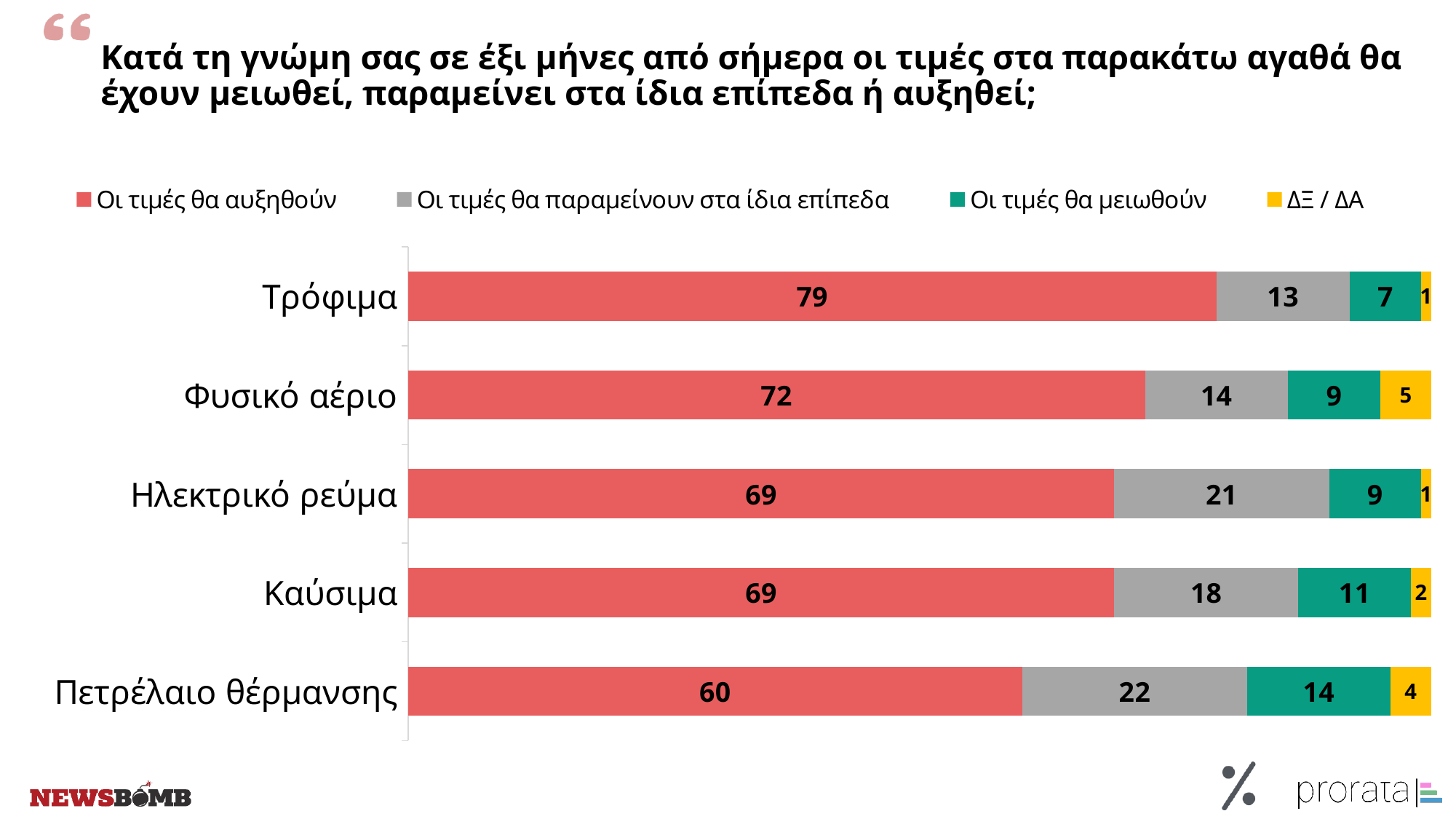
Which category has the lowest value for "Οι τιμές θα αυξηθούν"? Πετρέλαιο θέρμανσης What is the value of "Οι τιμές θα μειωθούν" for Καύσιμα? 11 What is the value of "ΔΞ / ΔΑ" for Φυσικό αέριο? 5 What kind of chart is shown on the slide? Stacked bar chart What is the difference between the "Οι τιμές θα αυξηθούν" values for Τρόφιμα and Πετρέλαιο θέρμανσης? 19 Which is larger: the "Οι τιμές θα παραμείνουν στα ίδια επίπεδα" value for Ηλεκτρικό ρεύμα or for Καύσιμα? Ηλεκτρικό ρεύμα What is the value of "Οι τιμές θα αυξηθούν" for Τρόφιμα? 79 Which category has the highest value for "Οι τιμές θα αυξηθούν"? Τρόφιμα What is the total of the stacked bar for Φυσικό αέριο? 100 How many series does the legend list? 4 How many categories are shown in the chart? 5 What is the value of "Οι τιμές θα παραμείνουν στα ίδια επίπεδα" for Πετρέλαιο θέρμανσης? 22